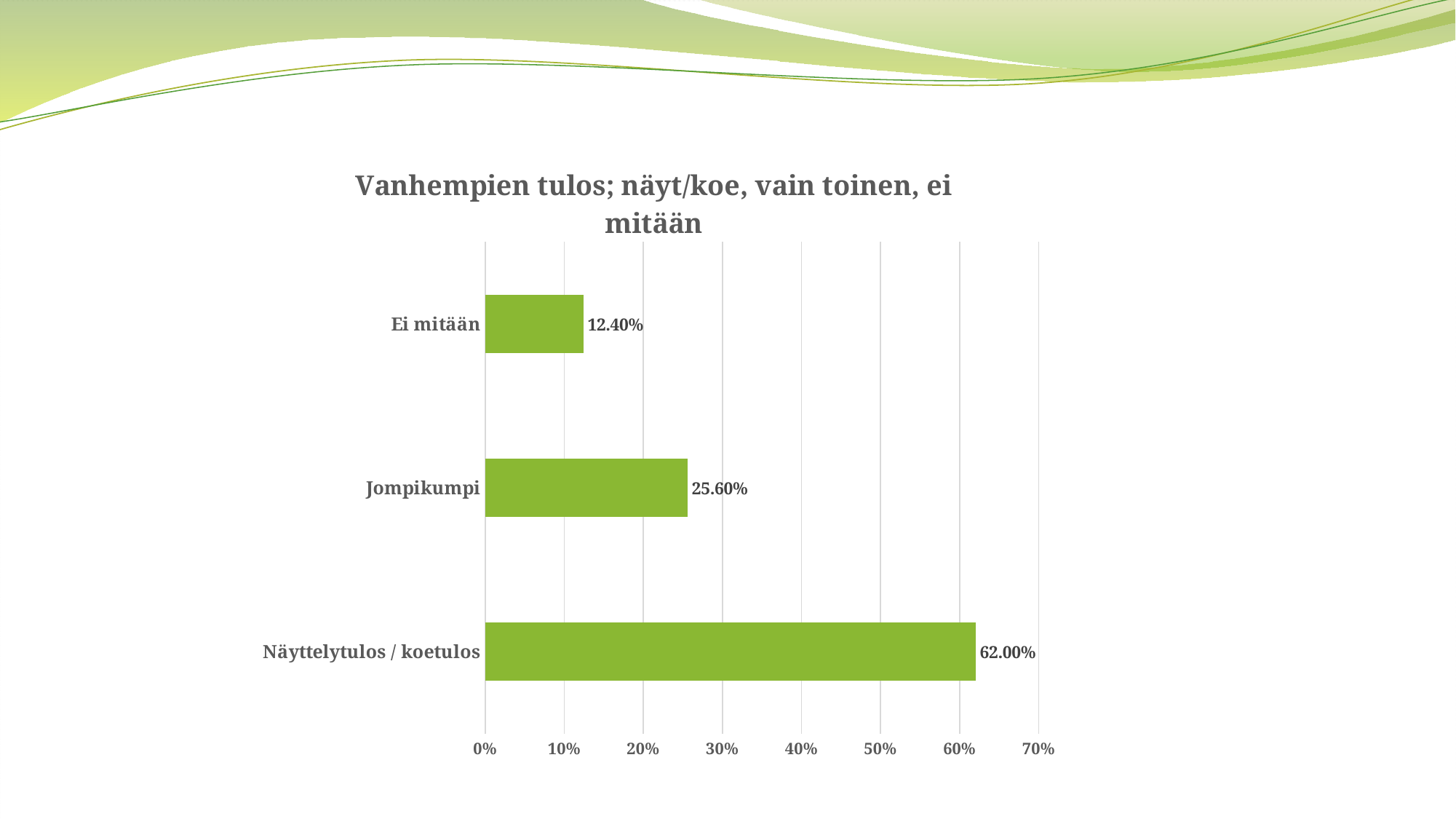
Which category has the lowest value? Ei mitään What is the difference between the values for Jompikumpi and Ei mitään? 13.20% Which is larger, the value for Jompikumpi or the value for Ei mitään? Jompikumpi What is the title of the chart? Vanhempien tulos; näyt/koe, vain toinen, ei mitään What is the difference between the values for Näyttelytulos / koetulos and Jompikumpi? 36.40% How many categories are shown in the chart? 3 What is the value for Jompikumpi? 25.60% What is the value for Näyttelytulos / koetulos? 62.00% Is the value for Näyttelytulos / koetulos greater or less than 50%? greater What kind of chart is shown on the slide? bar chart What is the value for Ei mitään? 12.40% Which category has the highest value? Näyttelytulos / koetulos